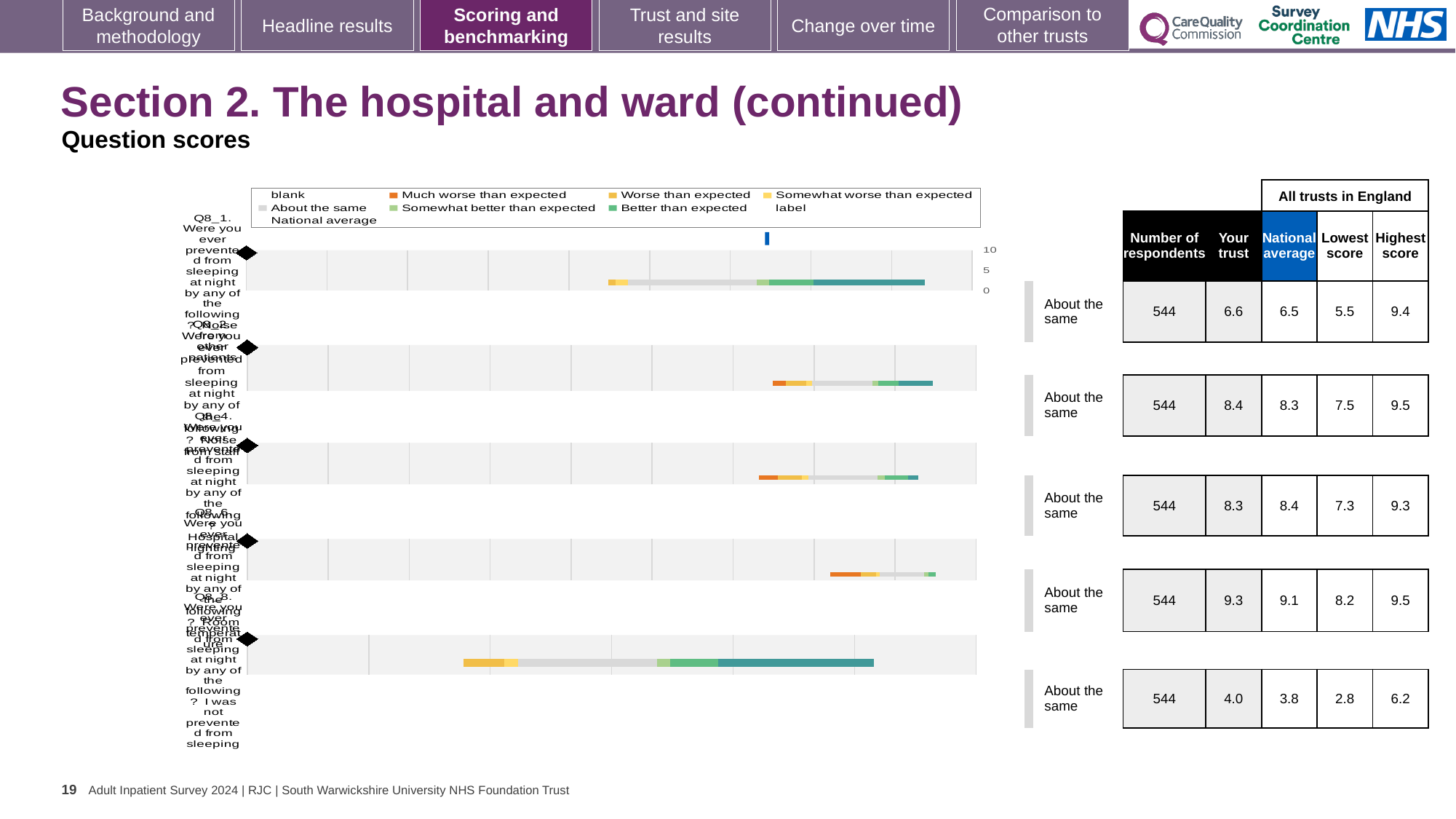
What is the 'Your trust' score for the bottom (fifth) row of the chart? 4.0 Which row of the chart has the highest 'Your trust' score? the fourth row (9.3) Which row of the chart has the lowest 'Your trust' score? the bottom (fifth) row (4.0) How many respondents are listed for the second row of the chart? 544 In the chart legend, what colour represents 'Much worse than expected'? orange For the bottom (fifth) row, what is the difference between the highest score and the lowest score? 3.4 What benchmark label is shown next to every bar in the chart? About the same For the top (first) row, which is larger: the 'Your trust' score or the national average? Your trust How many horizontal bars (question rows) does the chart show? 5 What is the national average for the bottom (fifth) row of the chart? 3.8 What kind of chart is shown on the slide? bar chart What is the 'Your trust' score for the top (first) row of the chart? 6.6